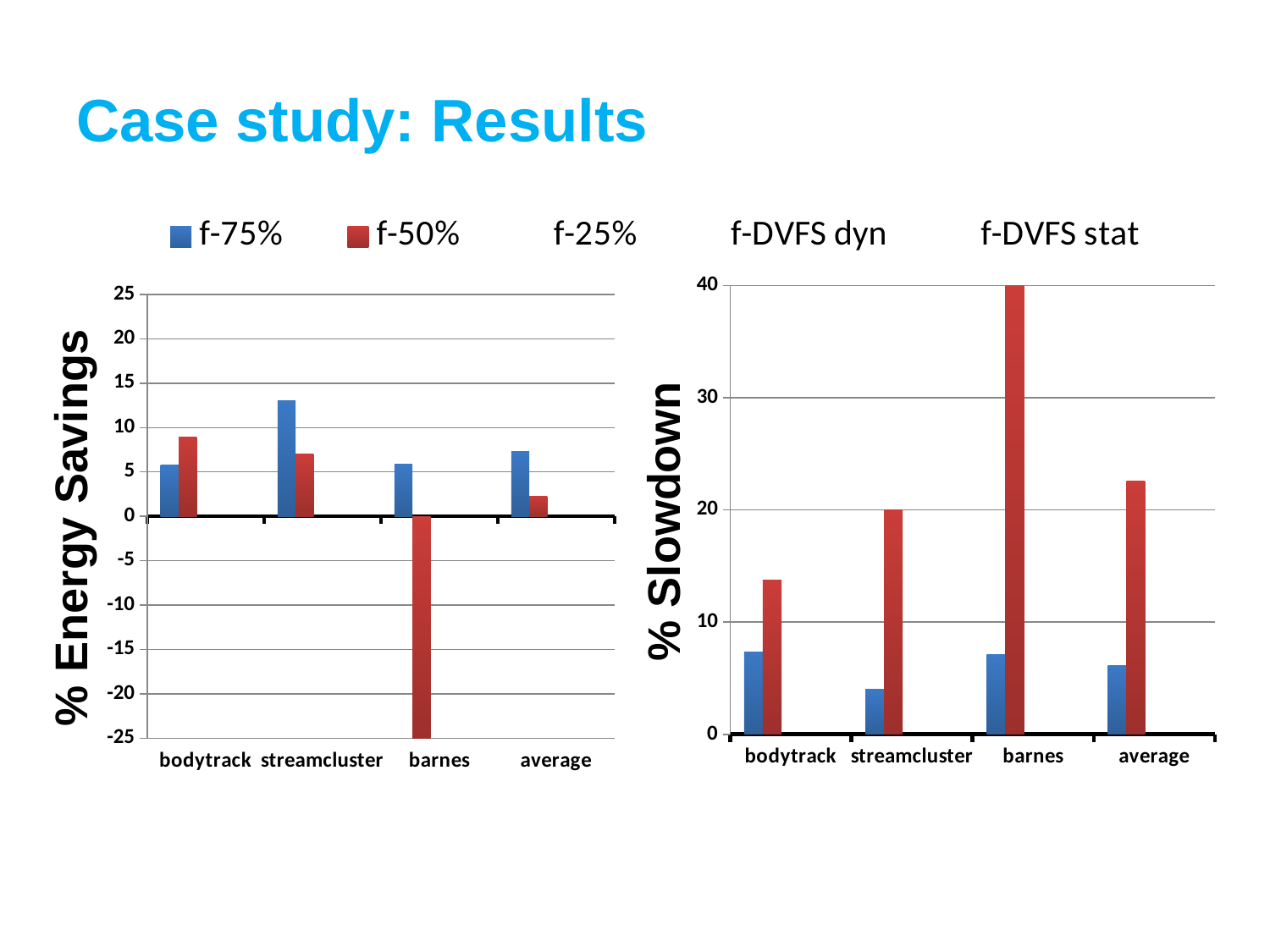
In the % Slowdown chart on the right, is the f-75% value for streamcluster greater or less than 10? less In the % Slowdown chart on the right, which is larger for average: f-75% or f-50%? f-50% What colour represents the f-50% series in the legend? red In the % Energy Savings chart on the left, which category has the lowest f-50% value? barnes What kind of chart is the % Energy Savings chart on the left? bar chart In the % Slowdown chart on the right, is the f-50% value for bodytrack greater or less than 10? greater In the % Energy Savings chart on the left, is the f-75% value for streamcluster greater or less than 10? greater In the % Energy Savings chart on the left, which is larger for bodytrack: f-75% or f-50%? f-50% In the % Energy Savings chart on the left, which category has the highest f-75% value? streamcluster In the % Slowdown chart on the right, which category has the highest f-50% value? barnes In the % Slowdown chart on the right, which category has the lowest f-75% value? streamcluster How many categories are shown on the x axis of the % Slowdown chart on the right? 4